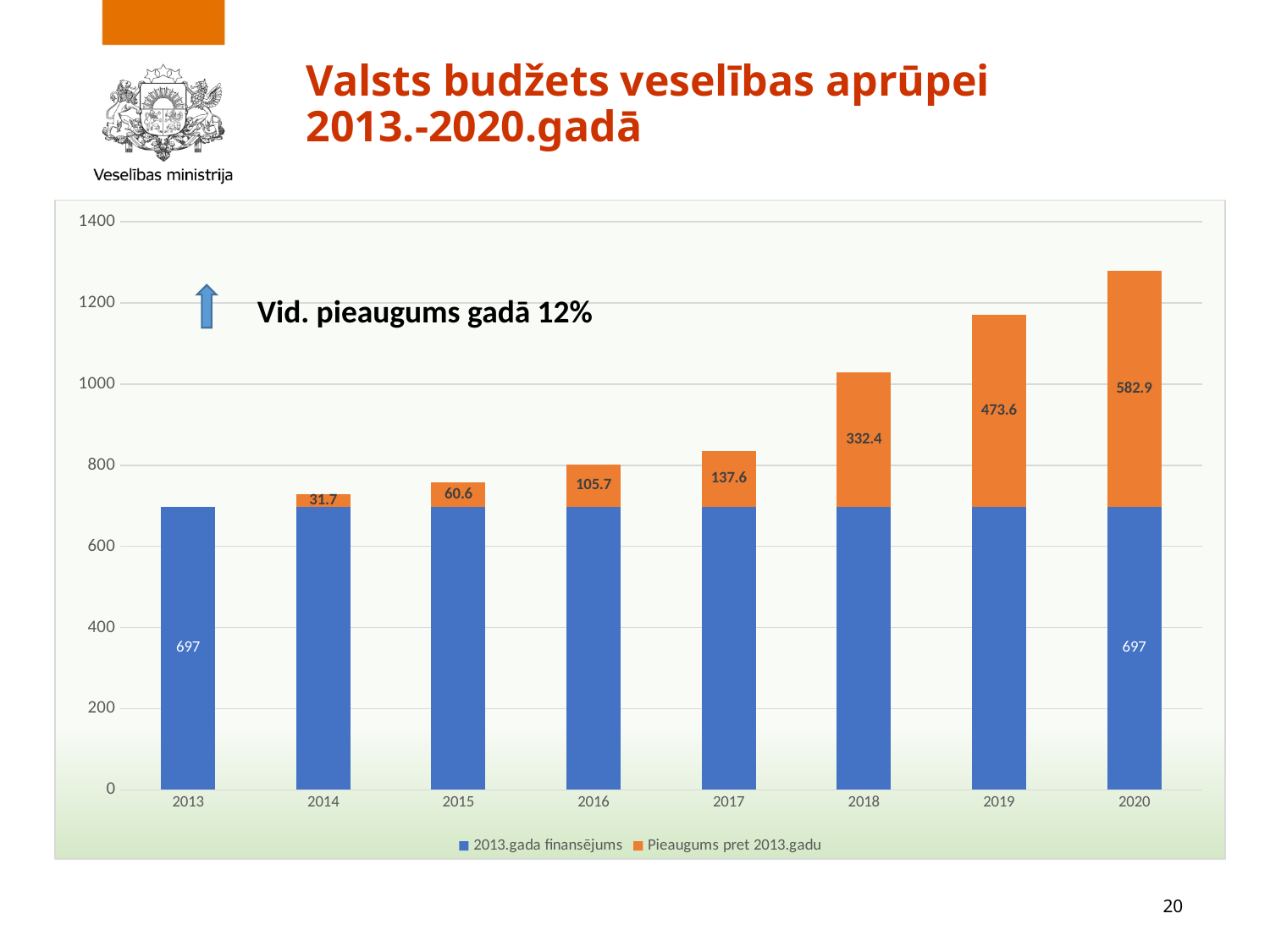
Which year has the lowest labelled value for the 'Pieaugums pret 2013.gadu' series? 2014 How many years are shown on the x axis? 8 What is the total of the stacked bar for 2020? 1279.9 What is the value of the '2013.gada finansējums' series for 2013? 697 Is the total height of the stacked bar for 2019 greater or less than 1100? greater How many series does the legend list? 2 What is the value of the 'Pieaugums pret 2013.gadu' series for 2015? 60.6 What is the difference between the 'Pieaugums pret 2013.gadu' values for 2020 and 2019? 109.3 What is the value of the 'Pieaugums pret 2013.gadu' series for 2020? 582.9 Which is larger: the 'Pieaugums pret 2013.gadu' value for 2017 or for 2016? 2017 What is the value of the 'Pieaugums pret 2013.gadu' series for 2018? 332.4 Which year has the highest value for the 'Pieaugums pret 2013.gadu' series? 2020